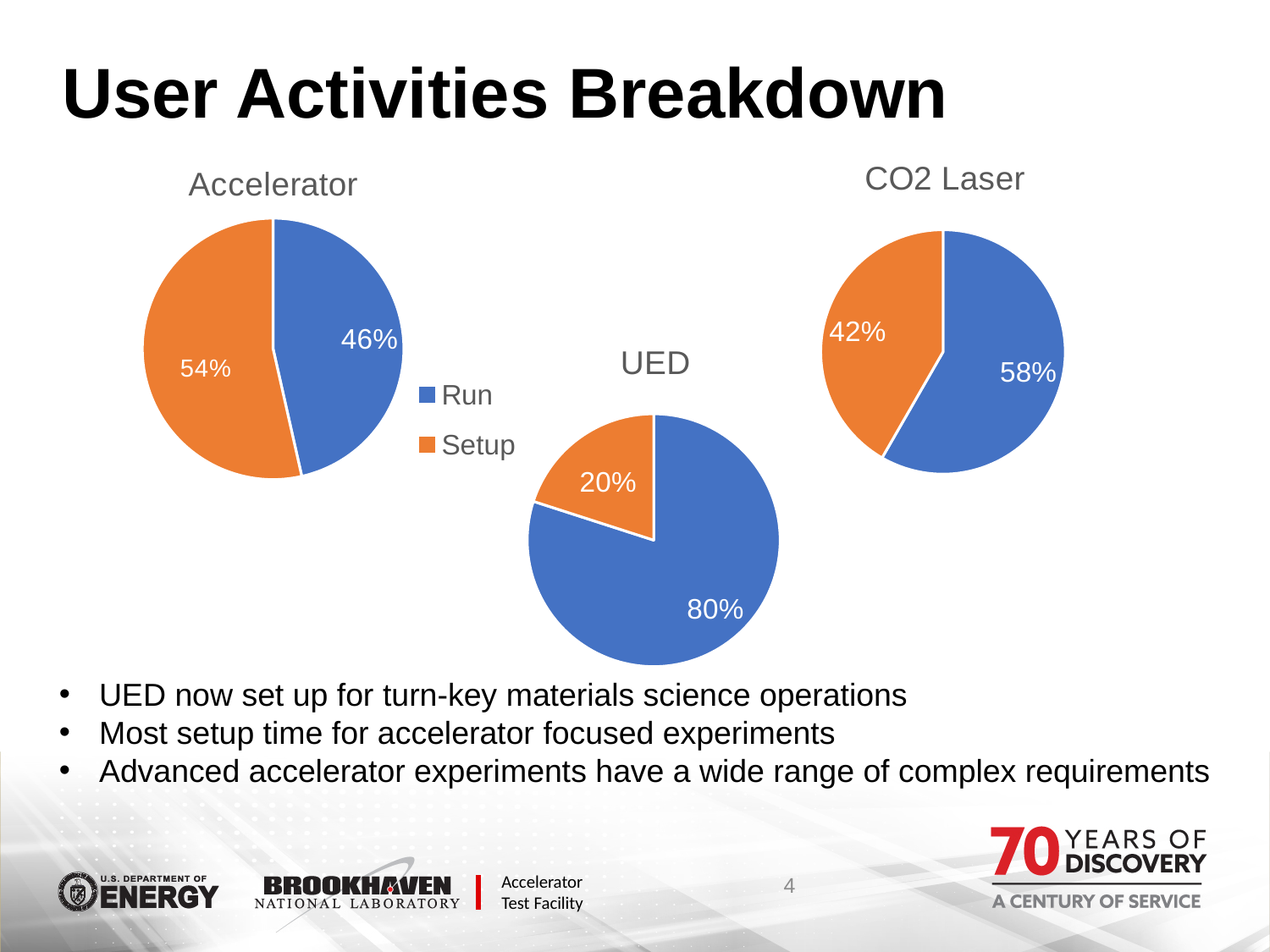
In the Accelerator pie chart, what share is Run? 46% In the CO2 Laser pie chart, what share is Setup? 42% In the UED pie chart, what is the difference between the Run and Setup shares? 60% In the UED pie chart, what share is Run? 80% In the UED pie chart, what share is Setup? 20% What kind of charts are shown on the slide? Pie charts In the CO2 Laser pie chart, what share is Run? 58% In the CO2 Laser pie chart, which is larger, Run or Setup? Run In the Accelerator pie chart, what share is Setup? 54% How many entries does the legend list? 2 In the UED pie chart, which slice is the largest? Run In the Accelerator pie chart, which slice is the smallest? Run